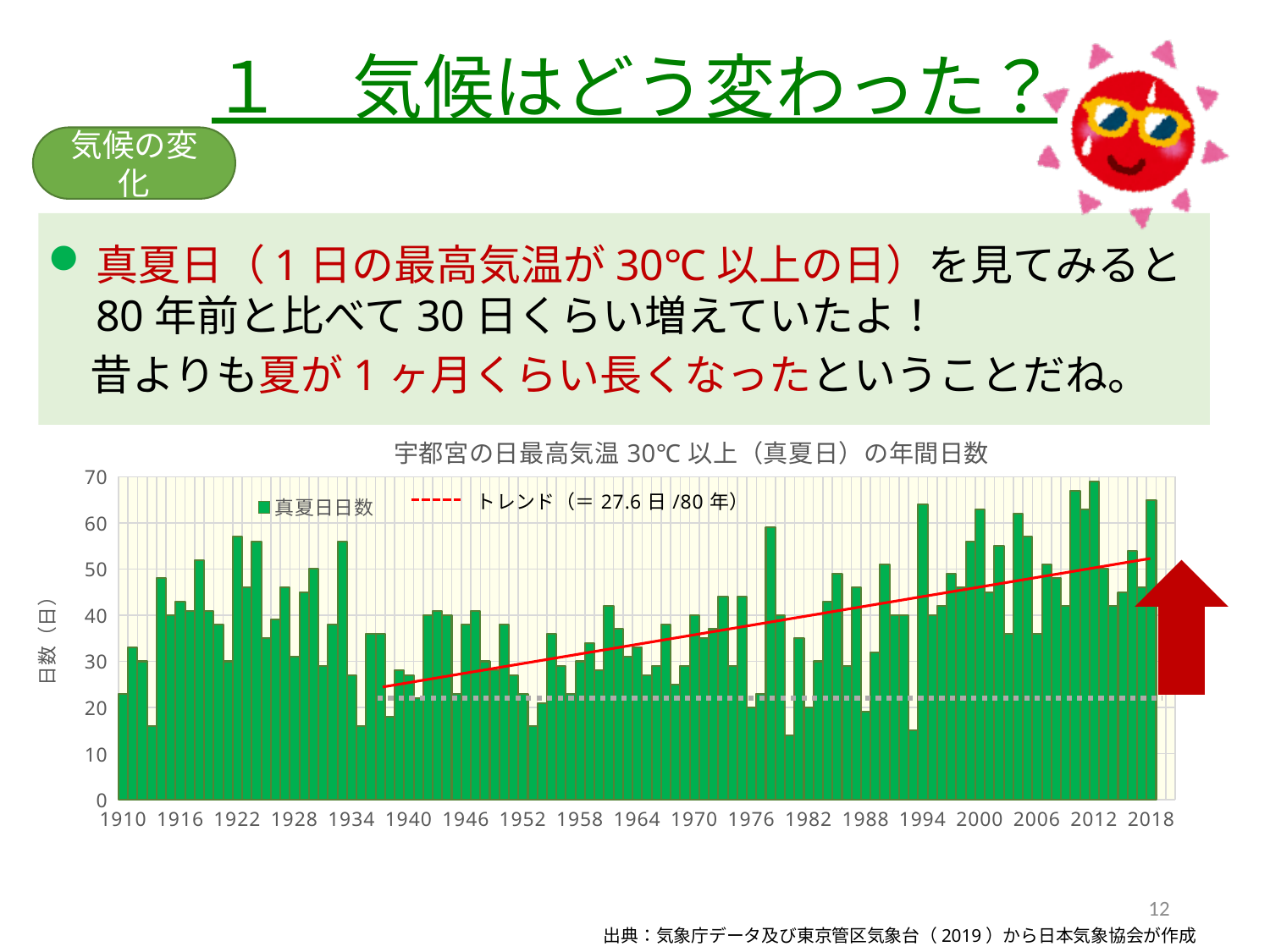
What is the last year shown on the x axis? 2018 Is the value for 1910 greater or less than 30? less Do the values of 真夏日日数 generally rise or fall from 1910 to 2018? rise How many series does the chart legend list? 2 What kind of chart is shown on the slide? bar chart What is the title of the chart? 宇都宮の日最高気温30℃以上（真夏日）の年間日数 Which year has the larger value, 1910 or 2018? 2018 Is the value for 1994 greater or less than 50? greater What is the first year shown on the x axis? 1910 What trend value is given in the legend for the トレンド line? 27.6日/80年 Is the value for 2018 greater or less than 60? greater